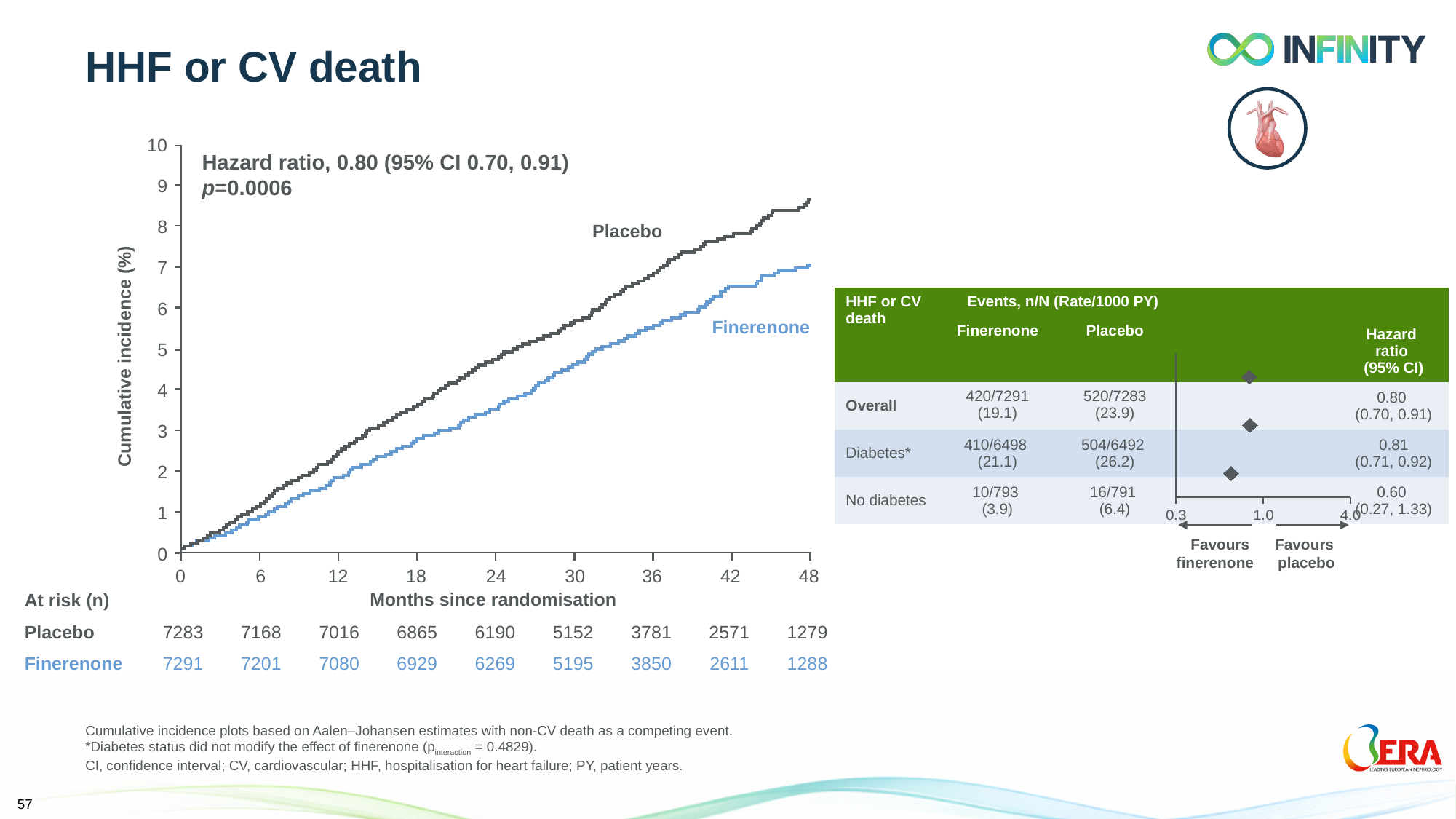
In the cumulative incidence chart's at-risk table, how many Finerenone patients were at risk at 48 months? 1288 How many treatment groups are plotted as curves in the cumulative incidence chart? 2 In the cumulative incidence chart, what hazard ratio with 95% CI is printed on the plot? 0.80 (95% CI 0.70, 0.91) In the cumulative incidence chart, what p-value is printed on the plot? p=0.0006 In the forest plot on the right, which subgroup has the lowest hazard ratio? No diabetes In the cumulative incidence chart, is the Placebo cumulative incidence at 48 months greater or less than 8%? greater In the cumulative incidence chart, do the curves rise or fall as months since randomisation increase? rise In the forest plot on the right, what is the hazard ratio (95% CI) for the Diabetes subgroup? 0.81 (0.71, 0.92) What kind of chart is the cumulative incidence plot on the left of the slide? line chart In the cumulative incidence chart, is the Finerenone cumulative incidence at 24 months greater or less than 4%? less In the cumulative incidence chart's at-risk table, how many Placebo patients were at risk at 24 months? 6190 In the cumulative incidence chart, which curve is higher at 48 months, Placebo or Finerenone? Placebo